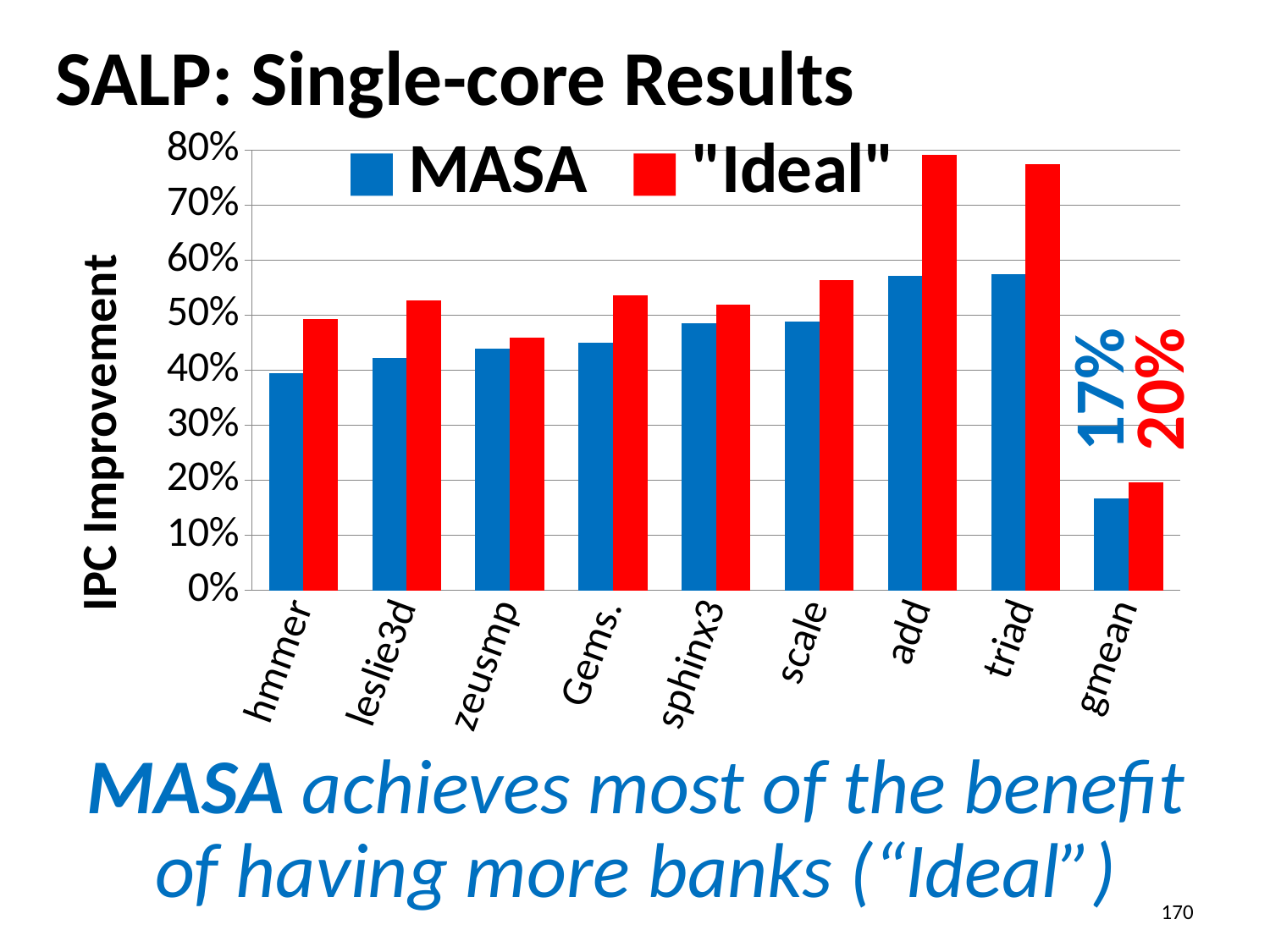
Is the "Ideal" value for add greater or less than 70%? greater How many categories are shown on the x axis? 9 Which category has the lowest MASA bar? gmean What is the difference between the "Ideal" and MASA values for gmean? 3% What kind of chart is shown on the slide? bar chart Which category has the highest "Ideal" bar? add What is the "Ideal" value for gmean? 20% Is the MASA value for triad greater or less than 50%? greater For hmmer, which is larger: the MASA value or the "Ideal" value? "Ideal" What is the MASA value for gmean? 17% Is the "Ideal" value for zeusmp greater or less than 50%? less How many series does the legend list? 2